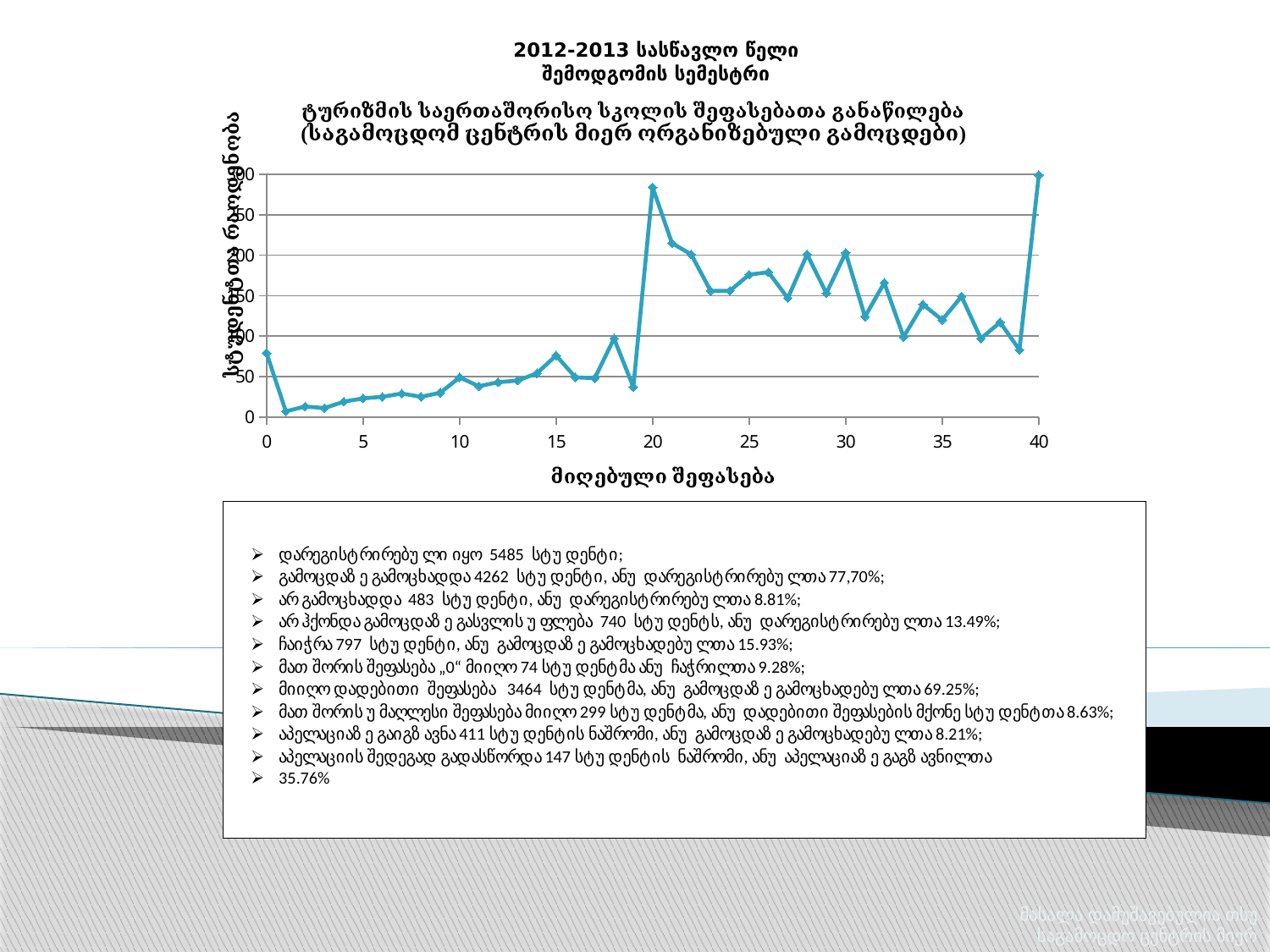
Is the value at score 25 greater or less than 150? greater Which is larger, the value at score 20 or the value at score 19? score 20 What is the title of the x axis of the chart? მიღებული შეფასება Is the value at score 5 greater or less than 50? less Do the values generally rise or fall along the x axis between score 21 and score 39? fall Is the value at score 39 greater or less than 100? less What is the title of the y axis of the chart? სტუდენტთა რაოდენობა What kind of chart is shown on the slide? line chart Which is larger, the value at score 21 or the value at score 25? score 21